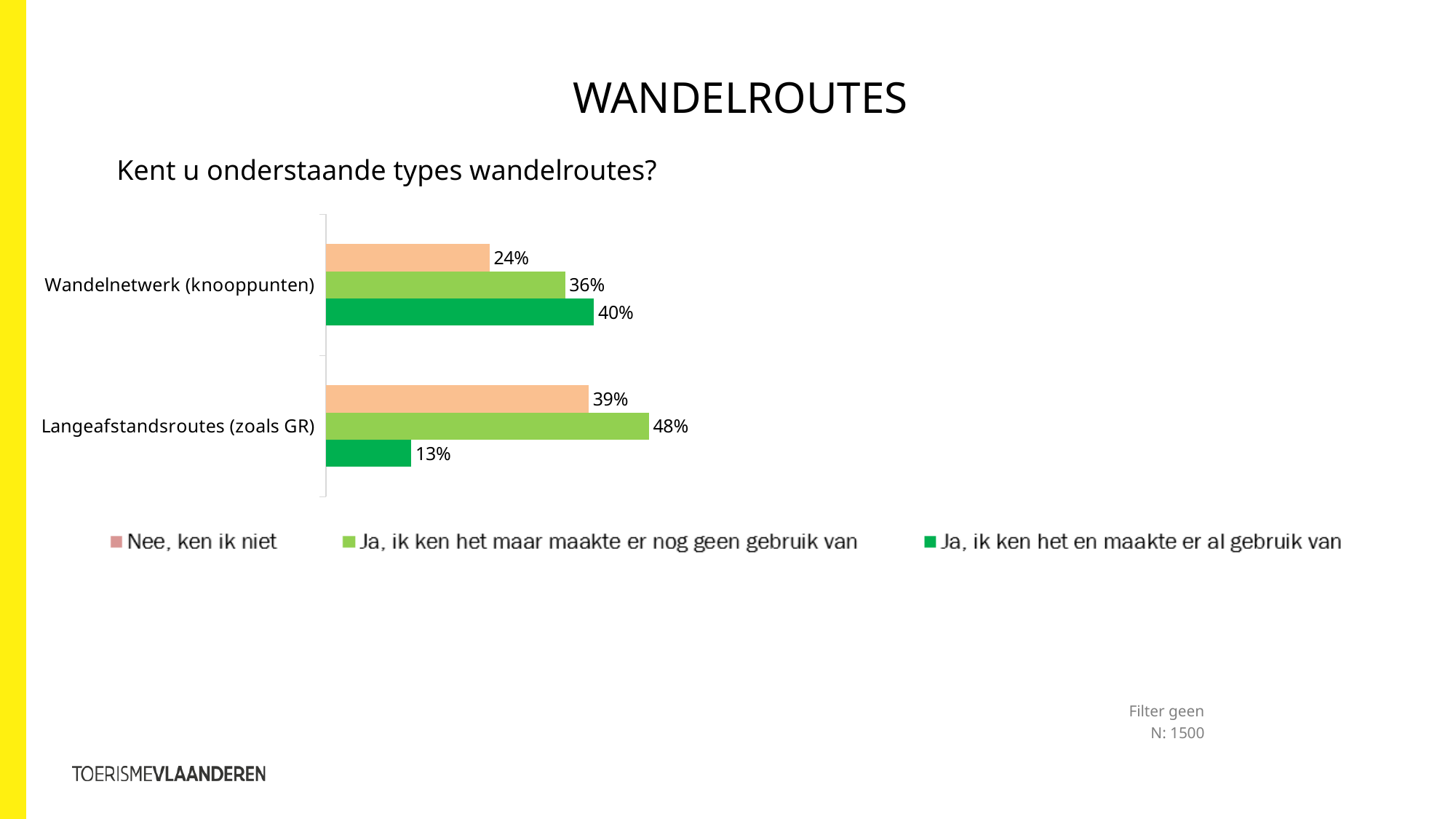
What is the total of the three values shown for Wandelnetwerk (knooppunten)? 100% Which is larger for Langeafstandsroutes (zoals GR): "Nee, ken ik niet" or "Ja, ik ken het maar maakte er nog geen gebruik van"? Ja, ik ken het maar maakte er nog geen gebruik van What percentage of respondents answered "Ja, ik ken het maar maakte er nog geen gebruik van" for Langeafstandsroutes (zoals GR)? 48% Which route type has the lowest value for "Nee, ken ik niet"? Wandelnetwerk (knooppunten) What kind of chart is shown on the slide? Bar chart What percentage of respondents answered "Ja, ik ken het en maakte er al gebruik van" for Langeafstandsroutes (zoals GR)? 13% How many series does the legend list? 3 What percentage of respondents answered "Nee, ken ik niet" for Wandelnetwerk (knooppunten)? 24% What is the sample size (N) shown on the slide? 1500 How many route types are shown on the chart? 2 What is the difference between the "Ja, ik ken het en maakte er al gebruik van" values for Wandelnetwerk (knooppunten) and Langeafstandsroutes (zoals GR)? 27% Which route type has the highest value for "Ja, ik ken het en maakte er al gebruik van"? Wandelnetwerk (knooppunten)